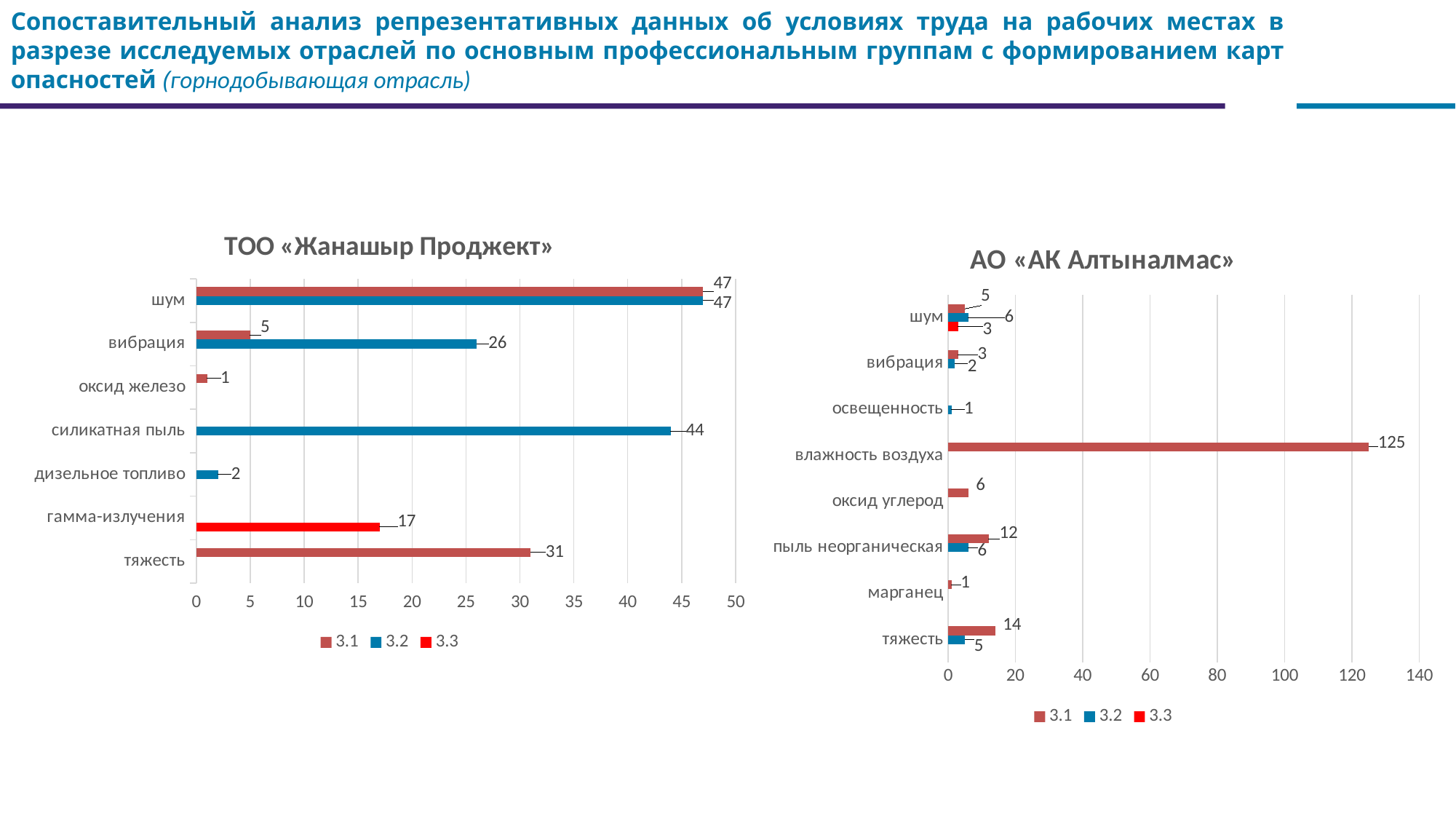
In the chart titled «АО «АК Алтыналмас»», what is the value of series 3.1 for влажность воздуха? 125 What type of chart is the chart titled «АО «АК Алтыналмас»»? bar chart In the chart titled «ТОО «Жанашыр Проджект»», what is the difference between the 3.2 and 3.1 values for вибрация? 21 In the chart titled «АО «АК Алтыналмас»», which category has the highest value for series 3.1? влажность воздуха In the chart titled «ТОО «Жанашыр Проджект»», is the 3.1 value for тяжесть greater or less than 30? greater In the chart titled «ТОО «Жанашыр Проджект»», which category has the highest value for series 3.1? шум In the chart titled «АО «АК Алтыналмас»», which is larger for пыль неорганическая: the 3.1 value or the 3.2 value? 3.1 In the chart titled «ТОО «Жанашыр Проджект»», how many categories are shown on the vertical axis? 7 In the chart titled «ТОО «Жанашыр Проджект»», what is the value of series 3.3 for гамма-излучения? 17 In the chart titled «ТОО «Жанашыр Проджект»», what is the value of series 3.2 for силикатная пыль? 44 In the chart titled «АО «АК Алтыналмас»», how many categories are shown on the vertical axis? 8 In the chart titled «АО «АК Алтыналмас»», how many series does the legend list? 3